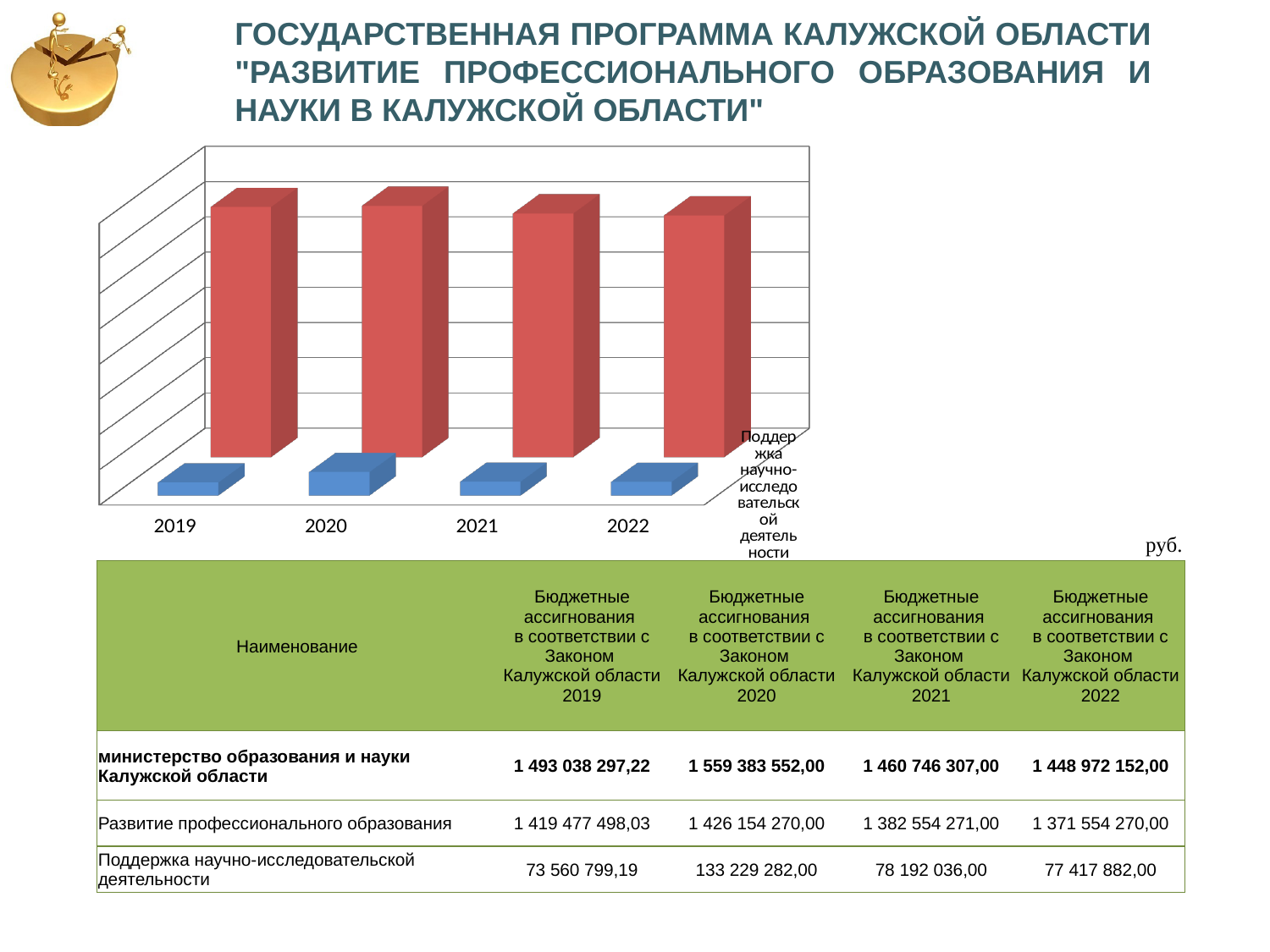
In 2019, which bar is taller, the red one or the blue one? the red one Using the table values, what is the difference between Поддержка научно-исследовательской деятельности in 2020 and in 2021? 55 037 246,00 According to the table, what is the value for Поддержка научно-исследовательской деятельности in 2019? 73 560 799,19 How many years are shown along the x axis of the chart? 4 According to the table, what is the value for Поддержка научно-исследовательской деятельности in 2020? 133 229 282,00 What kind of chart is shown on the slide? bar chart In which year is the blue bar (Поддержка научно-исследовательской деятельности) the tallest? 2020 In which year is the red bar the tallest? 2020 Do the red bars rise or fall from 2020 to 2022? fall What legend entry is readable to the right of the chart? Поддержка научно-исследовательской деятельности According to the table, what is the value for Развитие профессионального образования in 2022? 1 371 554 270,00 Which years are shown on the x axis of the chart? 2019, 2020, 2021, 2022